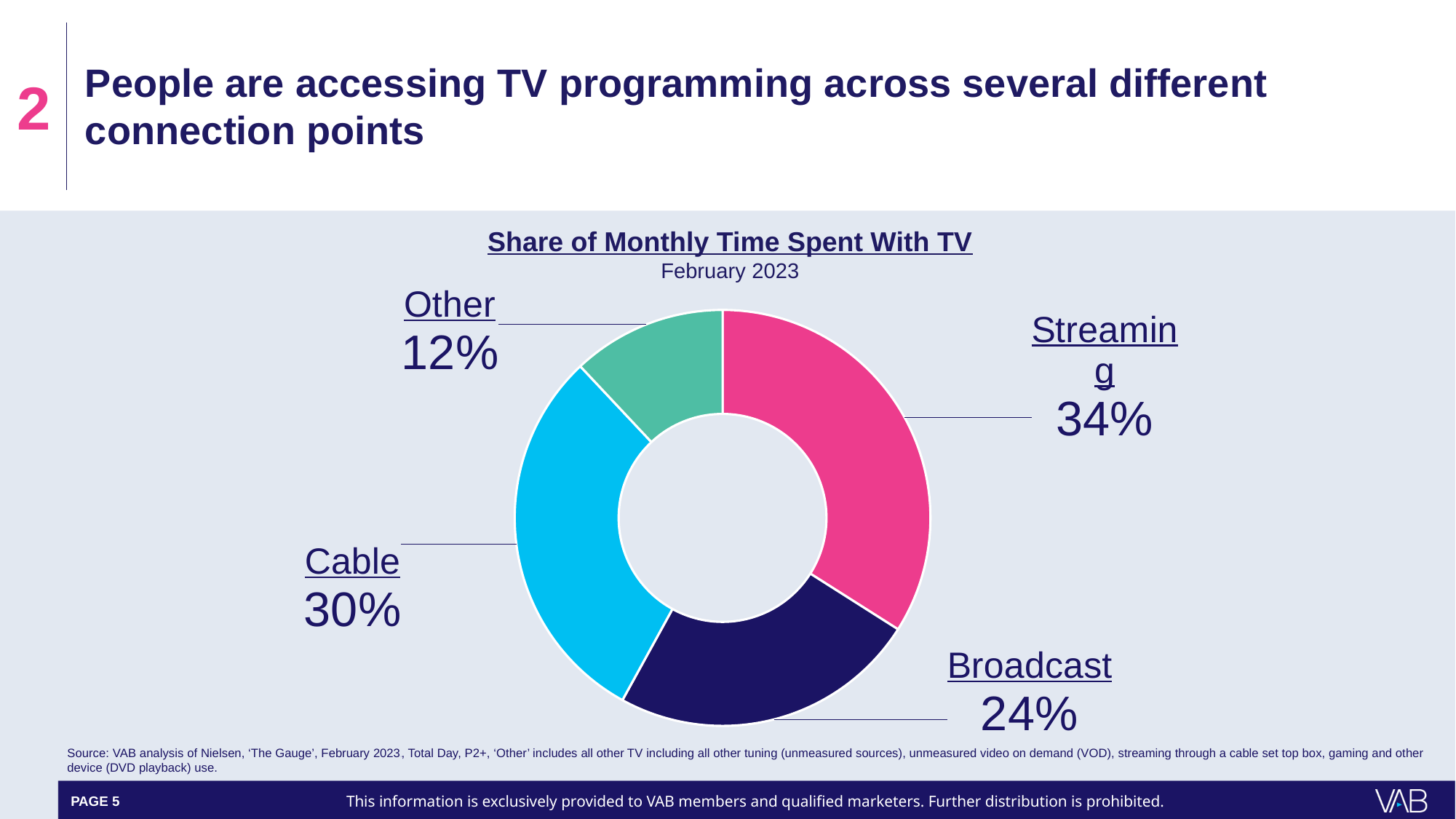
What kind of chart is shown on the slide? Doughnut (pie) chart What share of monthly time spent with TV does Other account for? 12% What month and year does the chart cover? February 2023 Which category has the largest share of monthly time spent with TV? Streaming How many categories are shown in the chart? 4 What share of monthly time spent with TV does Cable account for? 30% What share of monthly time spent with TV does Streaming account for? 34% Which category has the smallest share of monthly time spent with TV? Other What share of monthly time spent with TV does Broadcast account for? 24% What is the difference in share between Streaming and Broadcast? 10% What is the difference in share between Cable and Other? 18% Which has a larger share, Cable or Broadcast? Cable